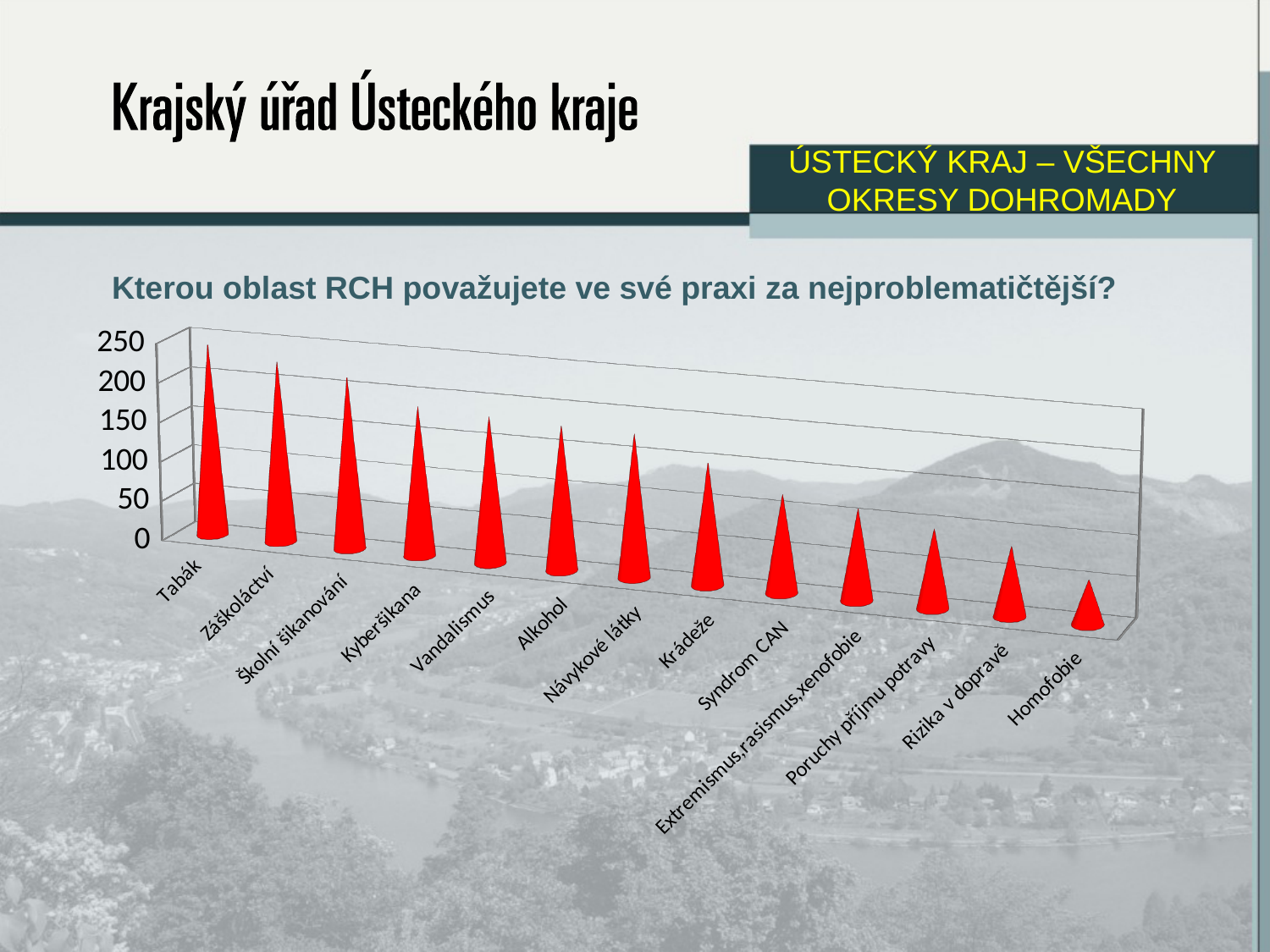
Which category has the lowest value in the chart? Homofobie Is the value for Krádeže greater or less than 200? less Which has a larger value, Rizika v dopravě or Kyberšikana? Kyberšikana How many categories are shown on the x axis of the chart? 13 Which category has the highest value in the chart? Tabák Is the value for Tabák greater or less than 200? greater Do the values rise or fall from left to right along the x axis? fall Is the value for Homofobie greater or less than 100? less Which has a larger value, Záškoláctví or Krádeže? Záškoláctví What is the title of the chart? Kterou oblast RCH považujete ve své praxi za nejproblematičtější? What kind of chart is shown on the slide? bar chart